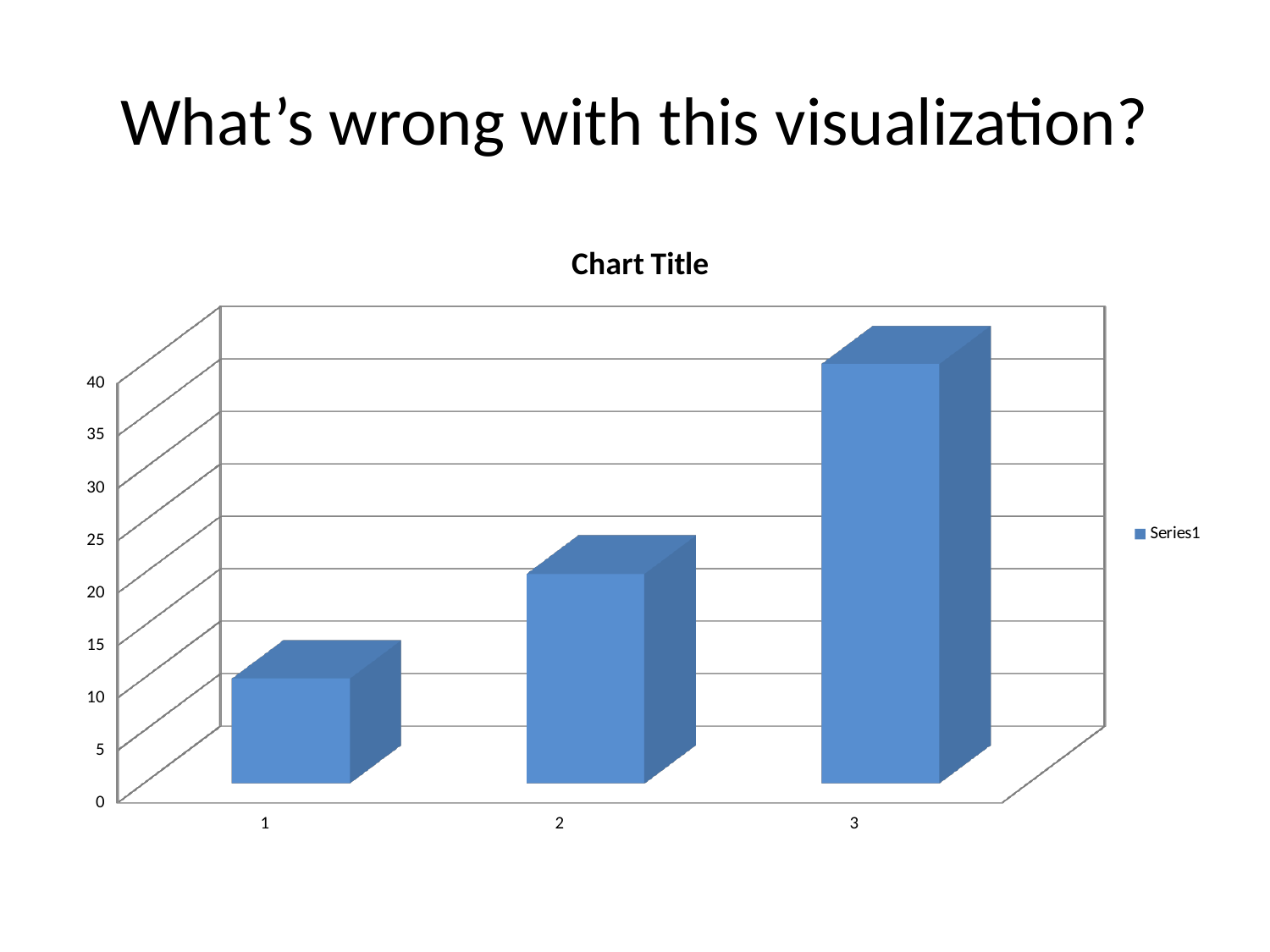
Which category has the highest bar? 3 What is the name of the series shown in the legend? Series1 Which is larger, the value for category 1 or the value for category 3? 3 Is the value for category 1 greater or less than 15? less Which category has the lowest bar? 1 How many categories are plotted on the x axis? 3 Is the value for category 3 greater or less than 30? greater Is the value for category 2 greater or less than 15? greater Which is larger, the value for category 2 or the value for category 1? 2 How many series does the legend list? 1 Do the values rise or fall from category 1 to category 3? rise What kind of chart is shown on the slide? bar chart